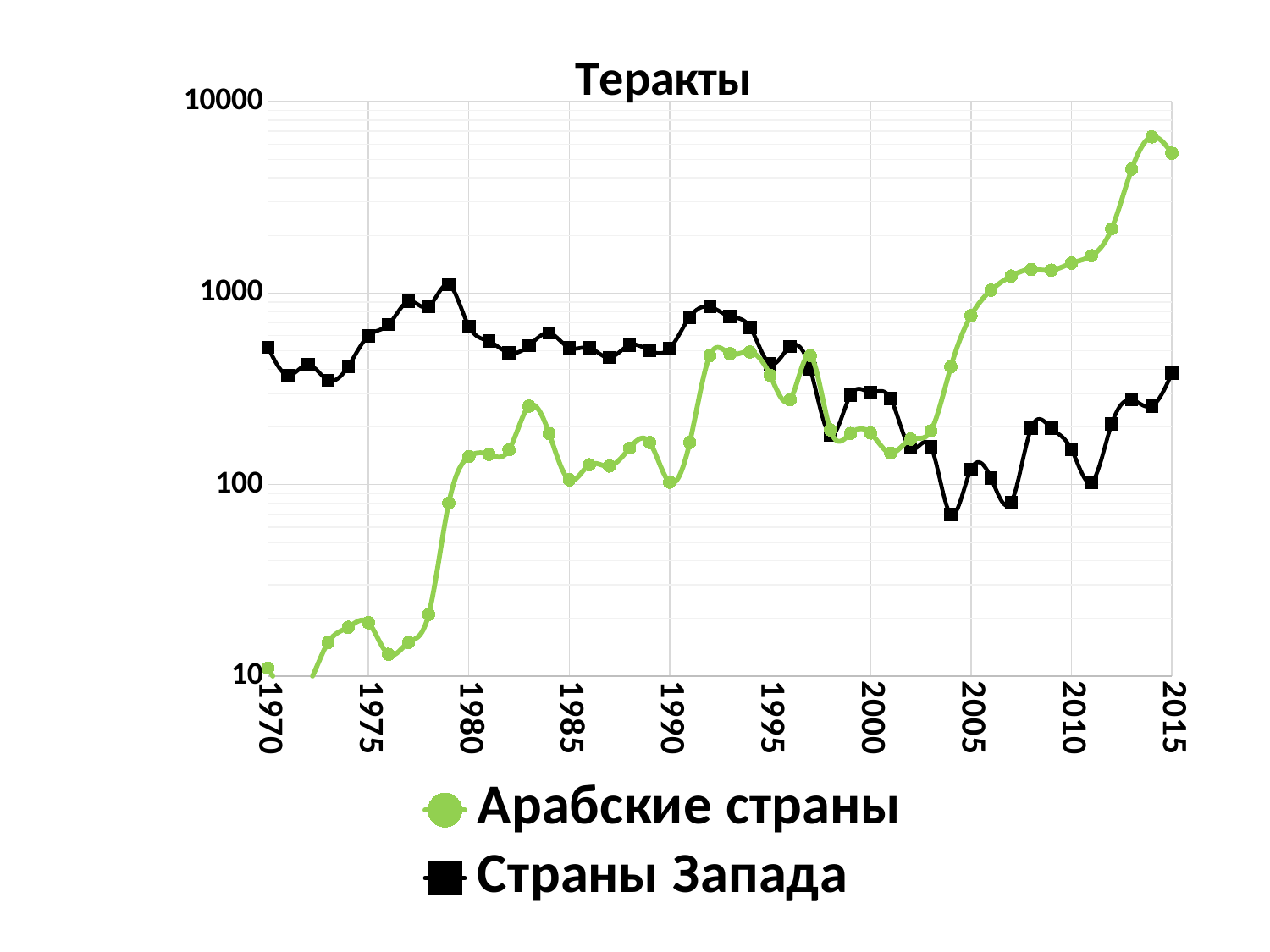
How many series does the legend list? 2 What kind of chart is shown on the slide? line chart Is the value for Арабские страны in 2015 greater or less than 1000? greater Is the value for Страны Запада in 1970 greater or less than 100? greater Is the value for Страны Запада in 2004 greater or less than 100? less In which year does the series Арабские страны reach its highest value? 2014 In 2015, which series has the higher value, Арабские страны or Страны Запада? Арабские страны Which colour is used for the series Арабские страны? green What is the title of the chart? Теракты Do the values for Арабские страны rise or fall between 2005 and 2014? rise In 1975, which series has the higher value, Арабские страны or Страны Запада? Страны Запада